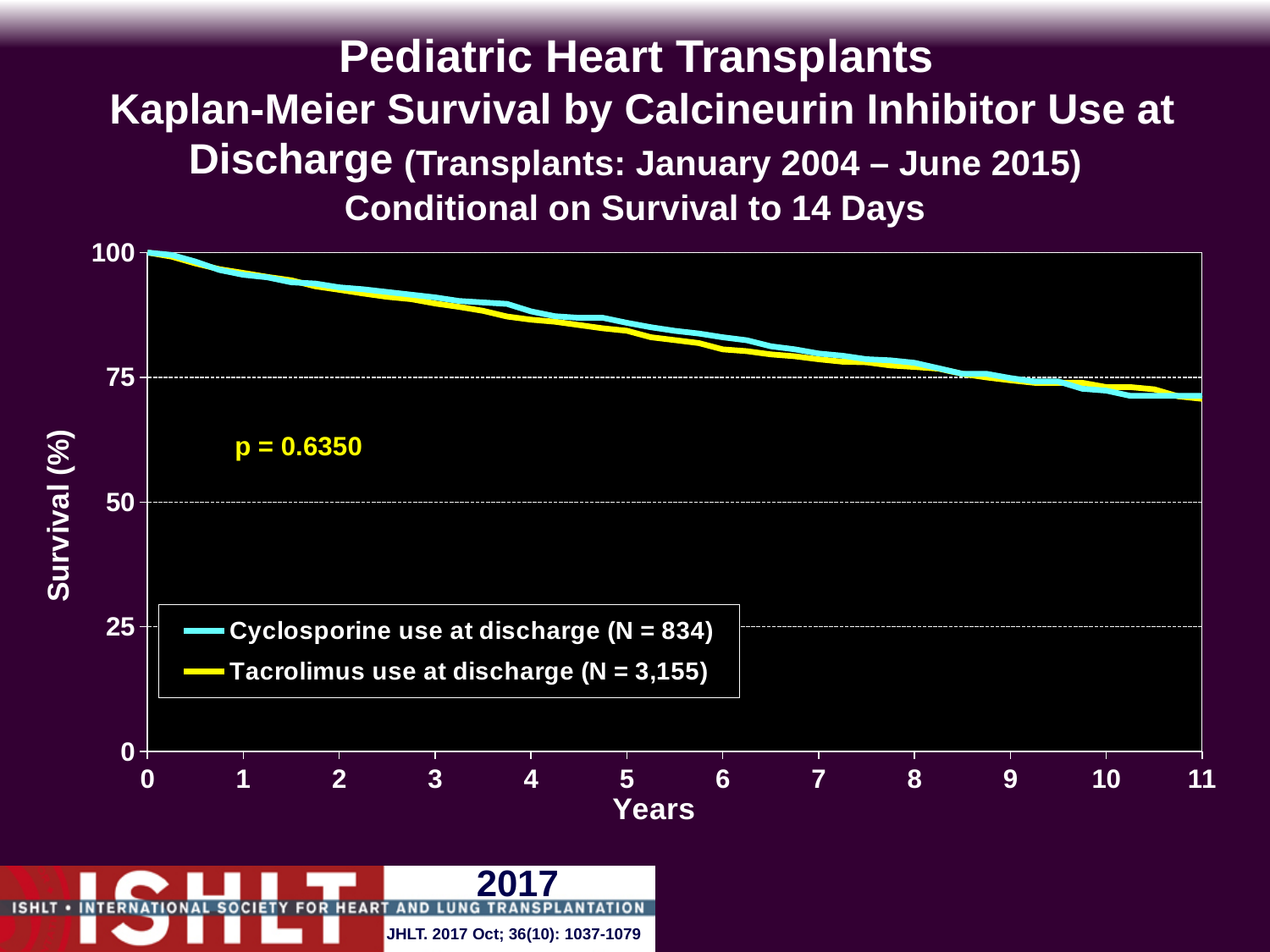
Is the survival value for Cyclosporine use at discharge at 11 years greater or less than 75? less Do the survival curves rise or fall as years increase? fall What kind of chart is shown on the slide? line chart Is the survival value for Cyclosporine use at discharge at 5 years greater or less than 75? greater Which colour represents Tacrolimus use at discharge in the legend? yellow What is the N for the Tacrolimus use at discharge group shown in the legend? 3,155 How many series does the legend list? 2 What is the N for the Cyclosporine use at discharge group shown in the legend? 834 What is the label of the y axis? Survival (%) Is the survival value for Tacrolimus use at discharge at 2 years greater or less than 75? greater What p-value is printed on the chart? p = 0.6350